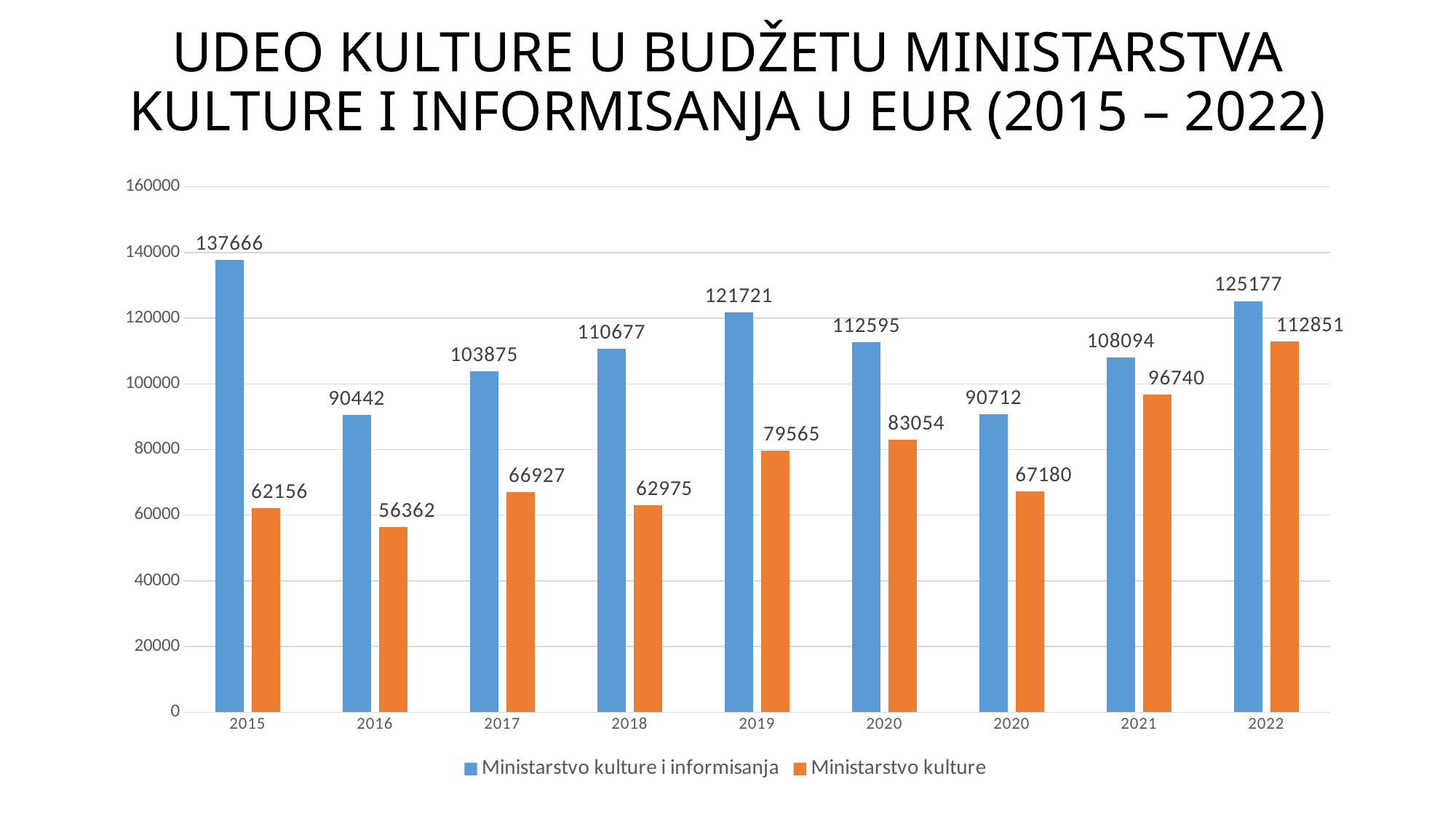
In which year is the Ministarstvo kulture value lowest? 2016 What is the difference between the Ministarstvo kulture i informisanja and Ministarstvo kulture values in 2015? 75510 What is the value for Ministarstvo kulture in 2019? 79565 What colour are the bars for Ministarstvo kulture? Orange In which year is the Ministarstvo kulture i informisanja value highest? 2015 How many series does the legend list? 2 Which is larger in 2018: the Ministarstvo kulture i informisanja value or the Ministarstvo kulture value? Ministarstvo kulture i informisanja What kind of chart is shown on the slide? Bar chart What is the value for Ministarstvo kulture i informisanja in 2015? 137666 What is the value for Ministarstvo kulture i informisanja in 2021? 108094 What is the value for Ministarstvo kulture in 2022? 112851 In which year is the Ministarstvo kulture value highest? 2022